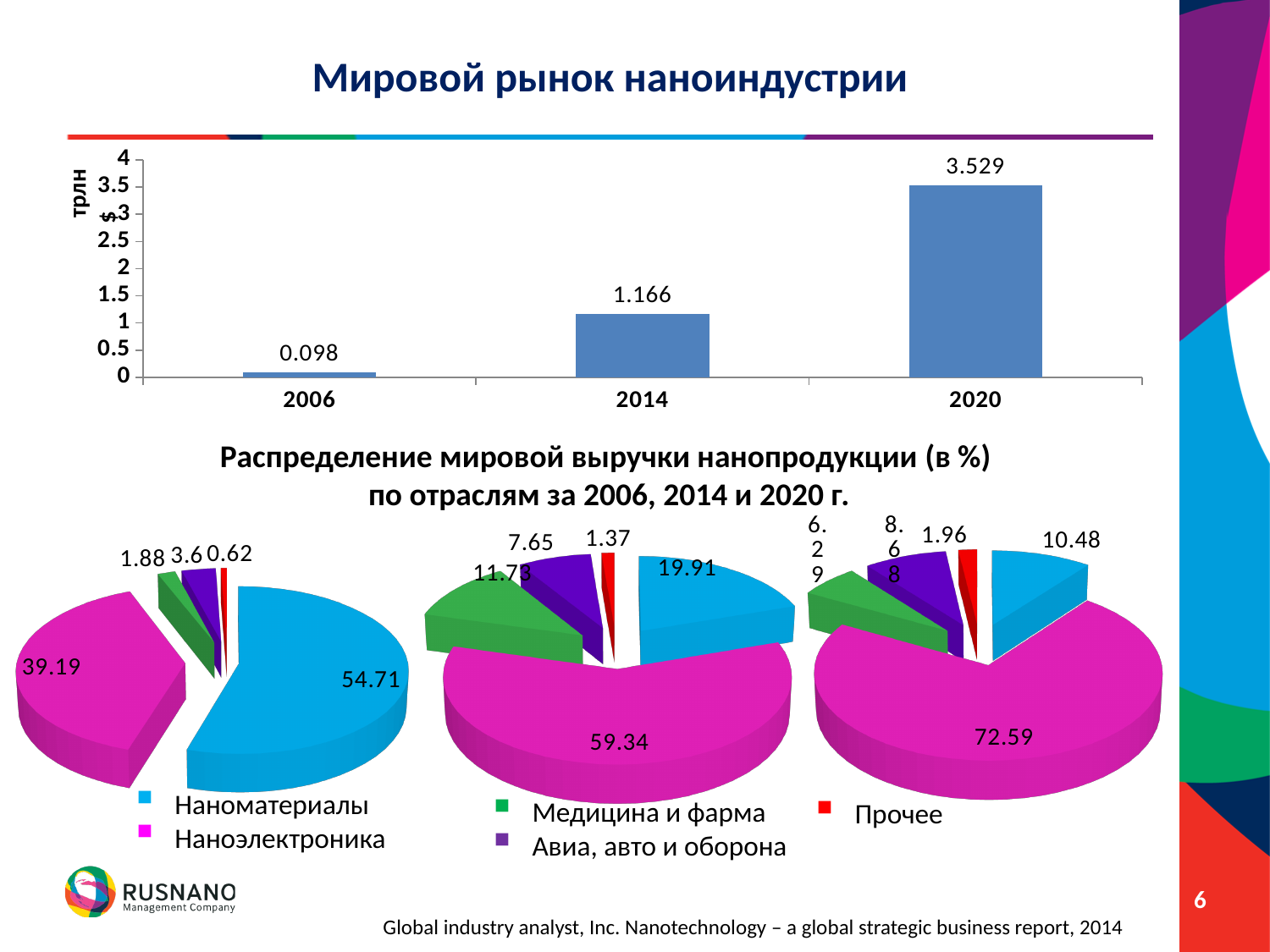
In the top bar chart, what is the difference between the 2020 and 2014 values? 2.363 What kind of chart is the top chart on the slide? bar chart In the left pie chart, which is larger: Наноматериалы or Наноэлектроника? Наноматериалы In the top bar chart, which year has the highest value? 2020 In the left pie chart, what is the share for Наноматериалы? 54.71 In the top bar chart, what is the value for 2006? 0.098 In the top bar chart, what is the value for 2020? 3.529 In the top bar chart, how many years are shown? 3 In the middle pie chart, which category has the largest share? Наноэлектроника In the top bar chart, do the values rise or fall from 2006 to 2020? rise In the right pie chart, what is the share for Наноэлектроника? 72.59 How many categories does the legend of the pie charts list? 5